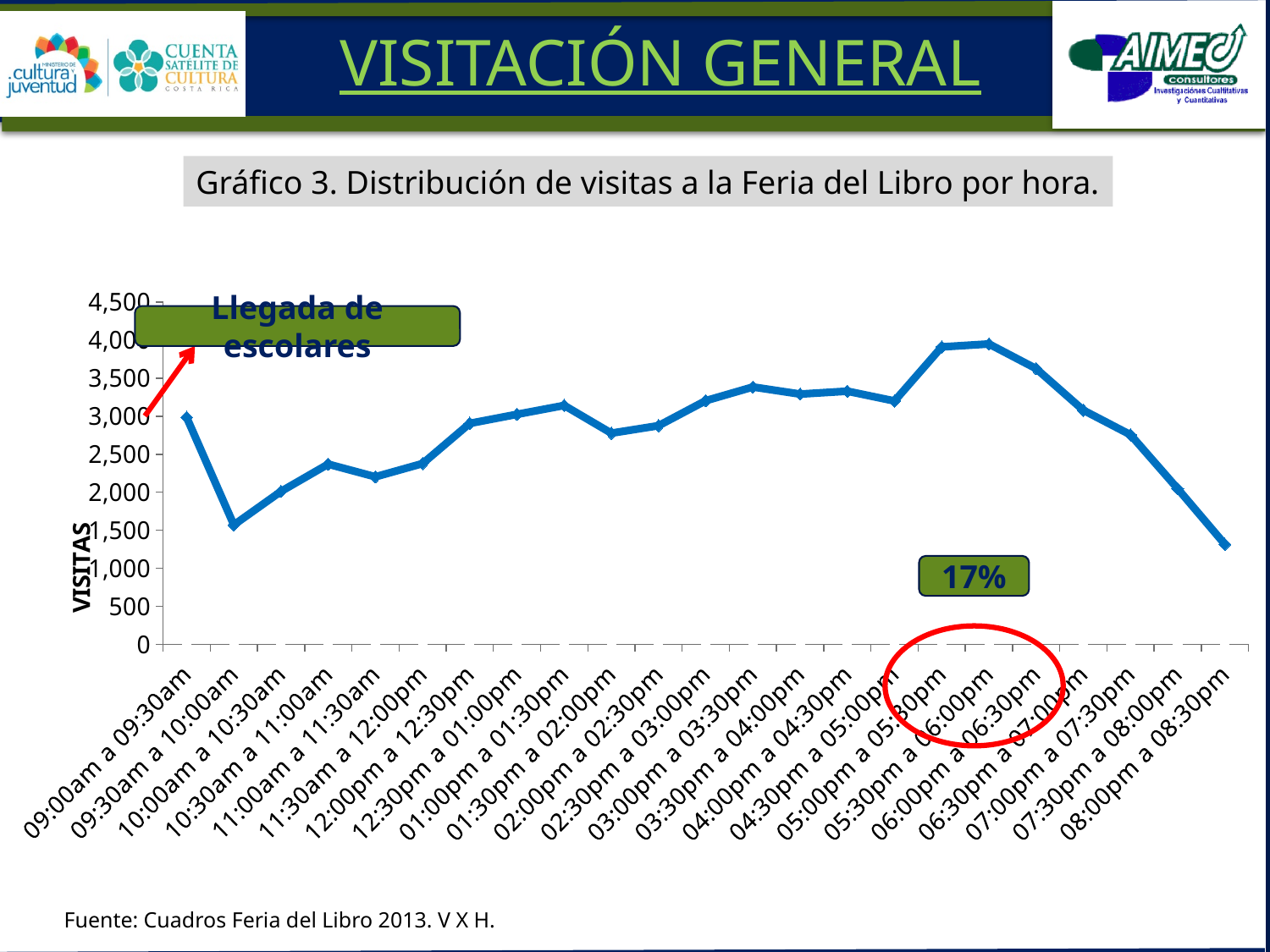
How many time intervals are plotted along the x axis? 23 What kind of chart is shown on the slide? Line chart Is the value for 09:30am a 10:00am greater or less than 2,000? less Which time interval has the lowest number of visits? 08:00pm a 08:30pm What is the title of the chart? Gráfico 3. Distribución de visitas a la Feria del Libro por hora. What is the label on the vertical axis? VISITAS Is the value for 08:00pm a 08:30pm greater or less than 1,500? less Do the visits rise or fall from 05:30pm a 06:00pm to 08:00pm a 08:30pm? fall Which has more visits, 05:30pm a 06:00pm or 08:00pm a 08:30pm? 05:30pm a 06:00pm Which has more visits, 09:00am a 09:30am or 09:30am a 10:00am? 09:00am a 09:30am Is the value for 09:00am a 09:30am greater or less than 2,500? greater